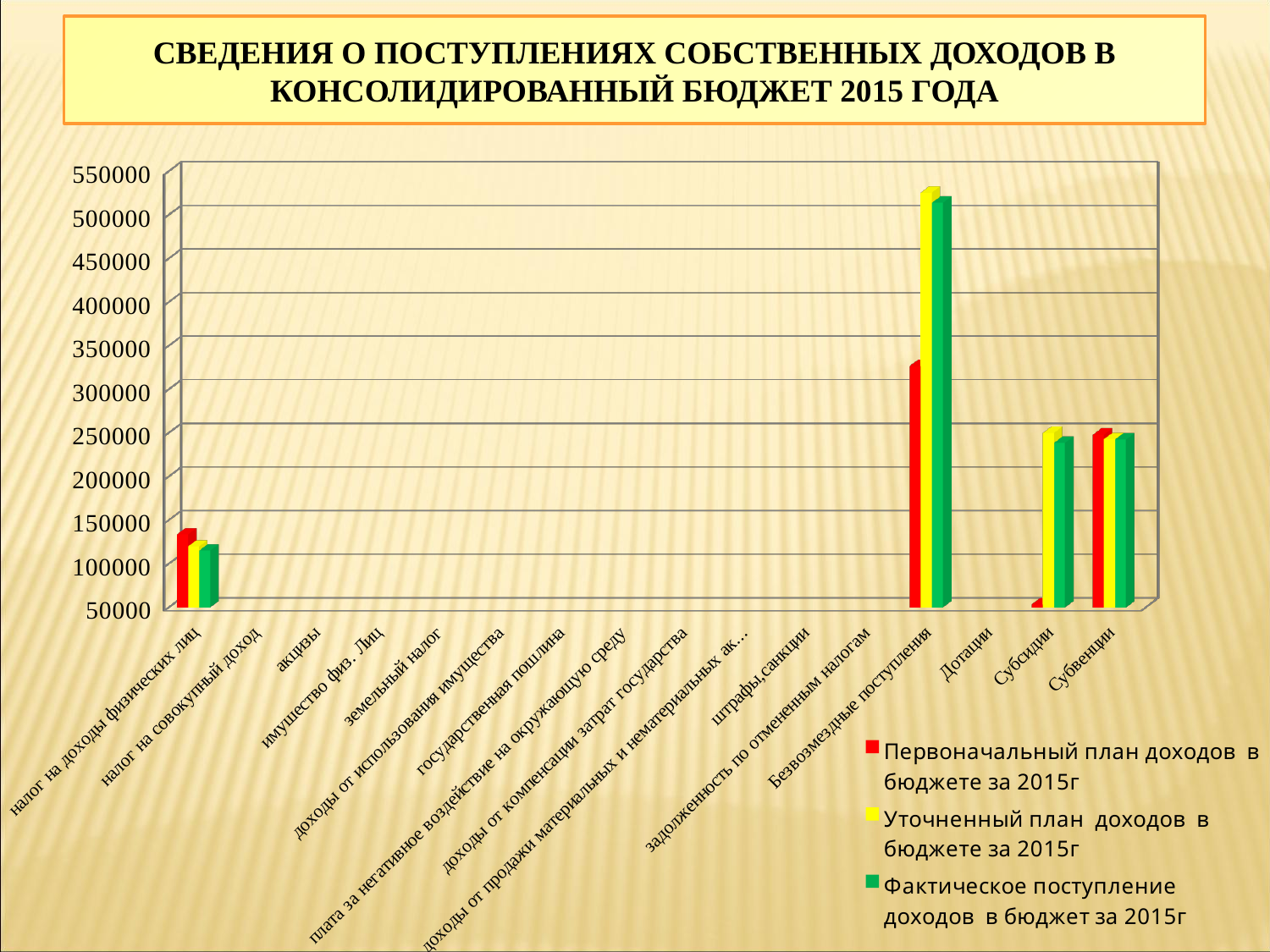
Is the value of 'Первоначальный план доходов в бюджете за 2015г' for налог на доходы физических лиц greater or less than 100000? greater How many series does the legend list? 3 For Субсидии, which is larger: 'Первоначальный план доходов в бюджете за 2015г' or 'Фактическое поступление доходов в бюджет за 2015г'? Фактическое поступление доходов в бюджет за 2015г Which category has the highest value for the series 'Фактическое поступление доходов в бюджет за 2015г'? Безвозмездные поступления What colour represents the series 'Фактическое поступление доходов в бюджет за 2015г' in the legend? green Is the value of 'Уточненный план доходов в бюджете за 2015г' for Безвозмездные поступления greater or less than 500000? greater What kind of chart is shown on the slide? bar chart How many categories are shown on the x axis? 16 Which category has the highest value for the series 'Первоначальный план доходов в бюджете за 2015г'? Безвозмездные поступления Is the value of 'Первоначальный план доходов в бюджете за 2015г' for Безвозмездные поступления greater or less than 300000? greater For Безвозмездные поступления, which is larger: 'Первоначальный план доходов в бюджете за 2015г' or 'Уточненный план доходов в бюджете за 2015г'? Уточненный план доходов в бюджете за 2015г